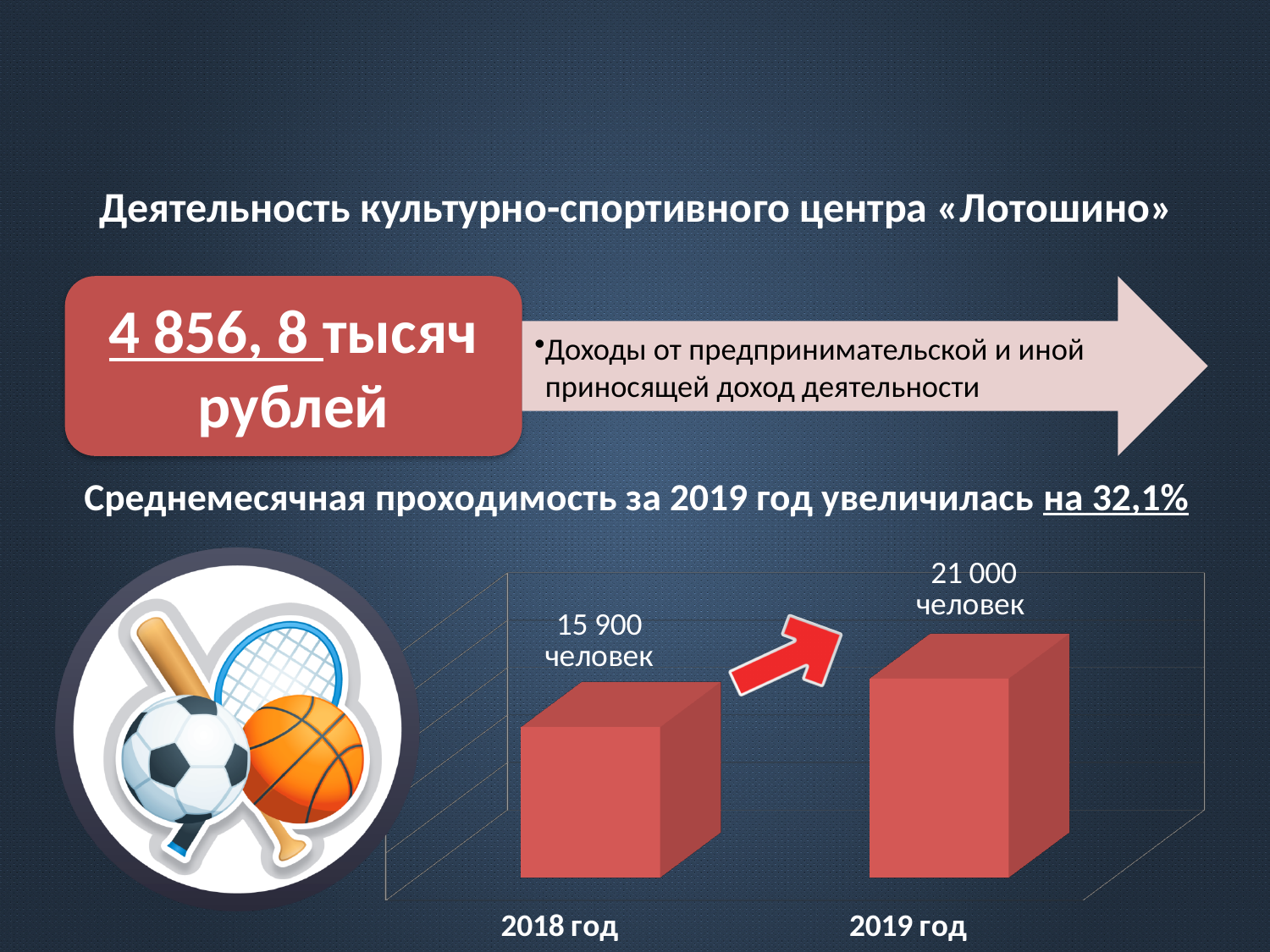
What is the value shown for 2018 год in the bar chart? 15 900 человек How many bars (categories) are plotted in the chart? 2 According to the text above the chart, by what percentage did average monthly attendance increase in 2019? на 32,1% Which year has the higher bar in the chart? 2019 год Which year has the lower bar in the chart? 2018 год What kind of chart is shown at the bottom of the slide? bar chart Do the values rise or fall from 2018 год to 2019 год? rise Is the value for 2019 год larger or smaller than the value for 2018 год? larger By how much does the value for 2019 год exceed the value for 2018 год? 5 100 человек What colour are the bars in the chart? red What is the value shown for 2019 год in the bar chart? 21 000 человек